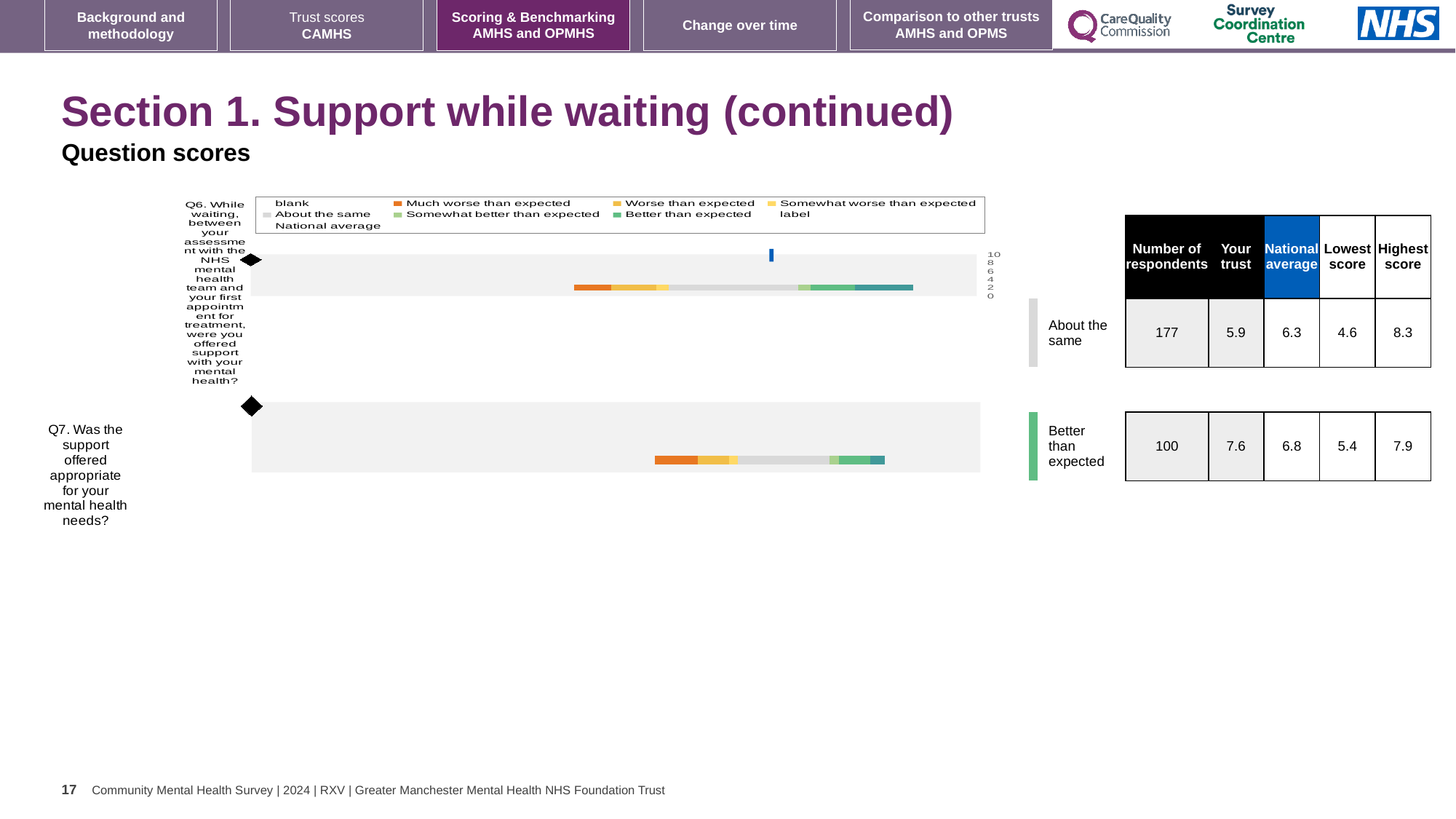
What is the highest score shown for Q6? 8.3 How many questions are plotted in the chart? 2 What is the 'Your trust' score for Q7 (Was the support offered appropriate for your mental health needs?)? 7.6 For Q6, which is larger: the trust's score or the national average? National average What is the national average score for Q6? 6.3 How many respondents are shown for Q6 in the table next to the chart? 177 What is the difference between the highest and lowest scores for Q6? 3.7 What benchmark category label is shown for Q7? Better than expected By how much does the trust's score for Q7 exceed the national average for Q7? 0.8 What kind of chart is used to show the question scores on this slide? Bar chart Which question has the higher 'Your trust' score, Q6 or Q7? Q7 What is the lowest score shown for Q7? 5.4